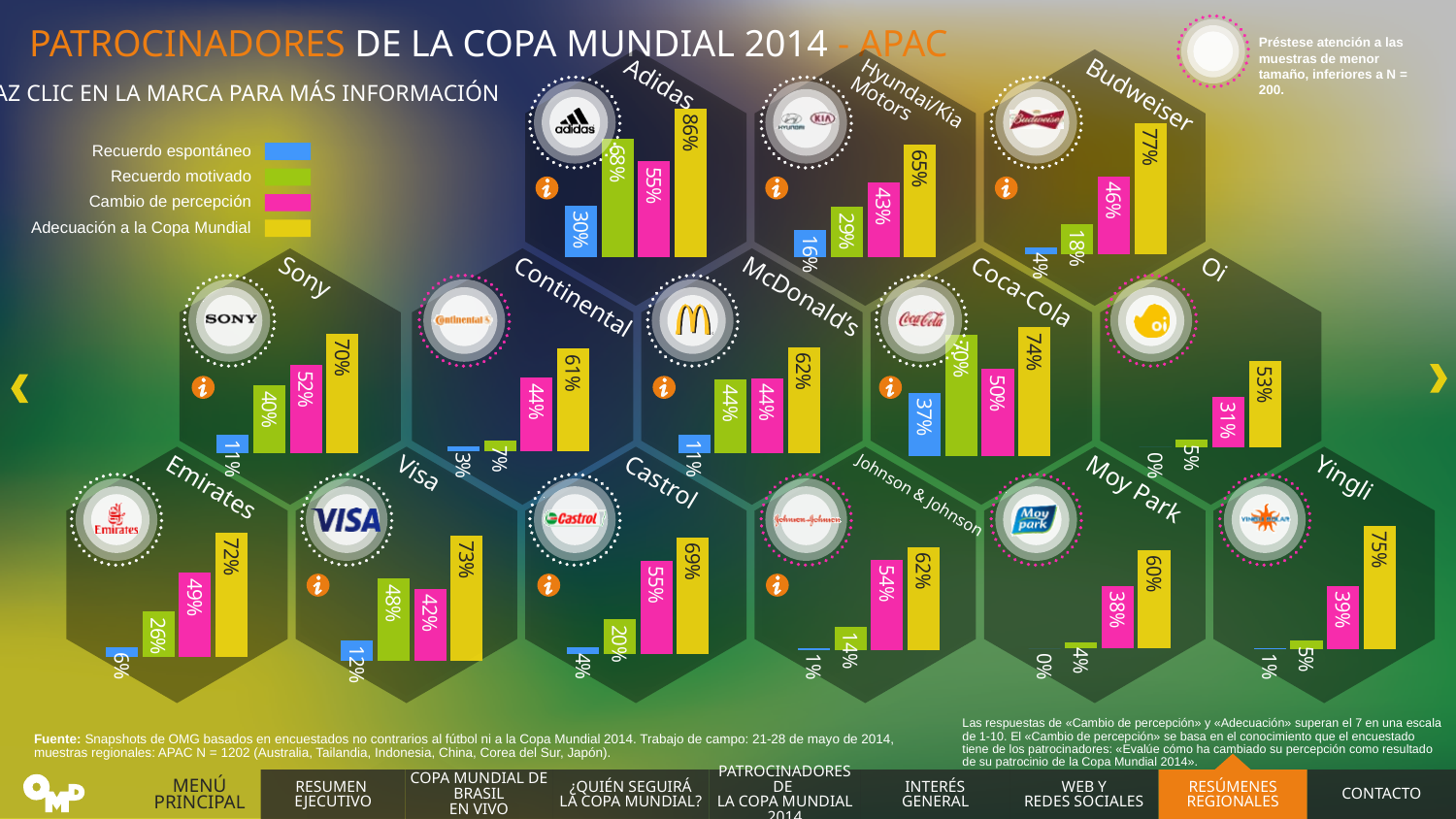
According to the legend, which colour represents Cambio de percepción? Pink Which is larger: Recuerdo motivado for Coca-Cola or Recuerdo motivado for Sony? Coca-Cola What kind of chart is used for each brand? Bar chart How many brand charts are shown on the slide? 14 In the Budweiser chart, what is the value for Cambio de percepción? 46% In the Visa chart, what is the value for Recuerdo motivado? 48% In the Emirates chart, what is the difference between Adecuación a la Copa Mundial and Cambio de percepción? 23% How many series does the legend list? 4 In the Oi chart, which series has the lowest value? Recuerdo espontáneo In the Coca-Cola chart, what is the value for Recuerdo espontáneo? 37% In the Adidas chart, what is the value for Adecuación a la Copa Mundial? 86% Across all the brand charts, which brand has the highest Adecuación a la Copa Mundial value? Adidas